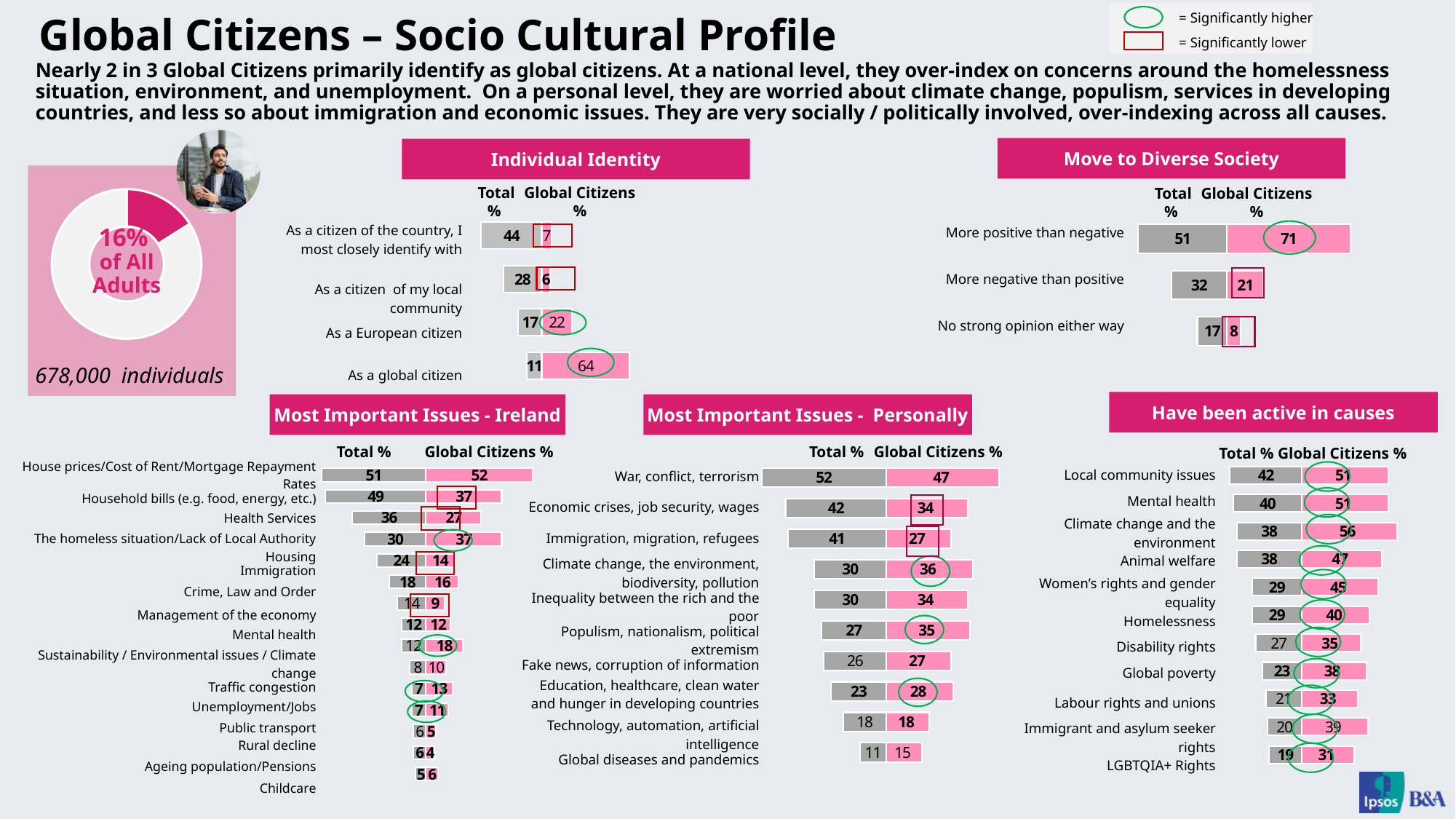
In the Move to Diverse Society chart, what is the Global Citizens % for 'More positive than negative'? 71 In the Most Important Issues - Personally chart, what is the Global Citizens % for 'Populism, nationalism, political extremism'? 35 In the Move to Diverse Society chart, what is the difference between the Global Citizens % and the Total % for 'More positive than negative'? 20 What percentage of all adults does the donut chart on the left show Global Citizens represent? 16% How many causes are listed in the Have been active in causes chart? 11 In the Individual Identity chart, what is the Total % for 'As a citizen of the country, I most closely identify with'? 44 In the Move to Diverse Society chart, which response has the lowest Global Citizens %? No strong opinion either way In the Individual Identity chart, what is the Global Citizens % for 'As a global citizen'? 64 In the Most Important Issues - Personally chart, which issue has the highest Total %? War, conflict, terrorism In the Have been active in causes chart, what is the Global Citizens % for 'Climate change and the environment'? 56 In the Have been active in causes chart, what is the difference between the Global Citizens % and the Total % for 'Global poverty'? 15 In the Most Important Issues - Personally chart, which is larger for 'Immigration, migration, refugees': the Total % or the Global Citizens %? Total %